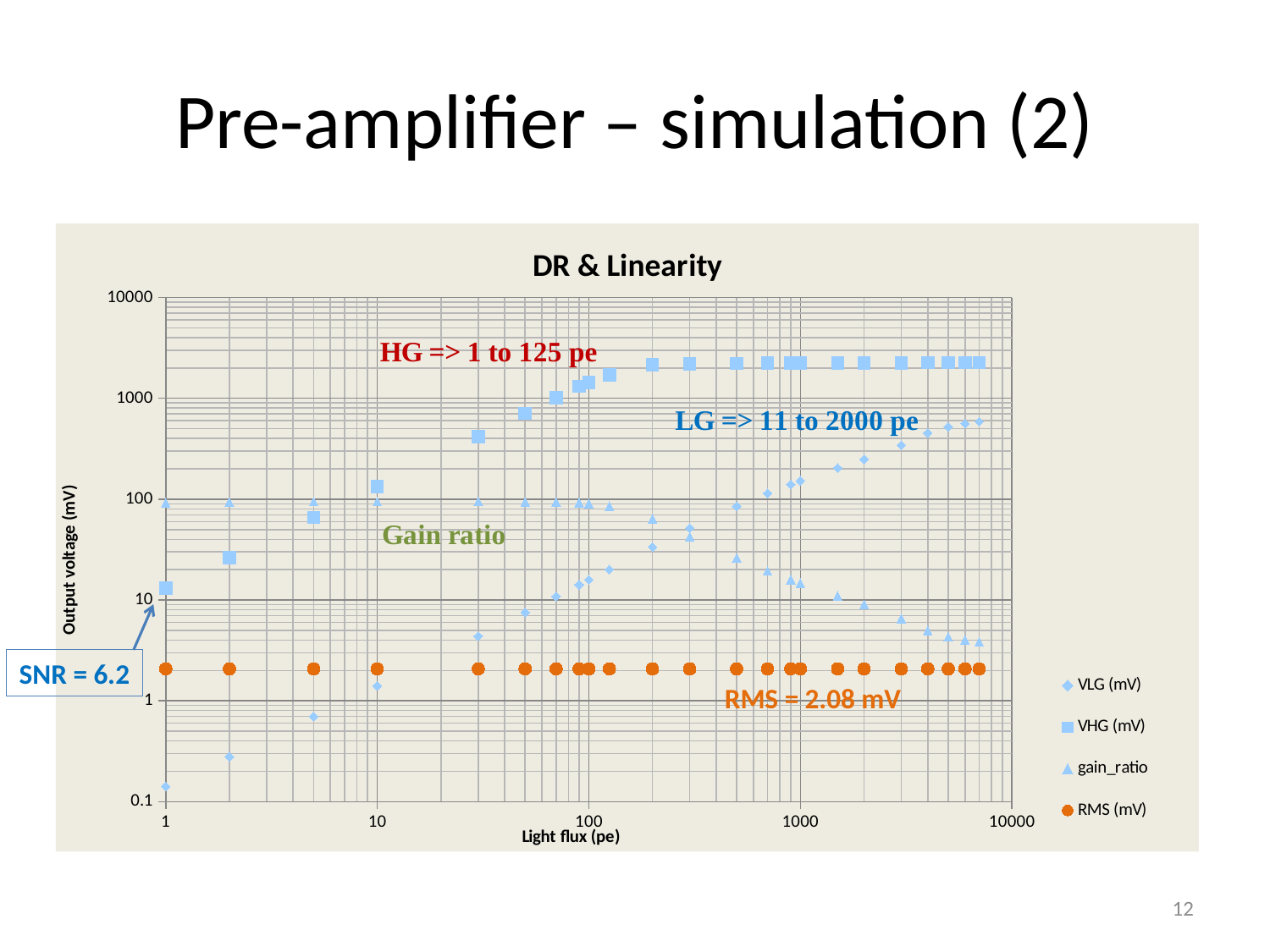
Is the gain_ratio value at a light flux of 5000 pe greater or less than 10? less What RMS value is annotated on the chart? RMS = 2.08 mV At a light flux of 1000 pe, which is larger, VHG (mV) or VLG (mV)? VHG (mV) How many series does the chart legend list? 4 Does the VLG (mV) series rise or fall as light flux increases? rise What is the title of the chart? DR & Linearity Is the VHG (mV) value at a light flux of 1000 pe greater or less than 1000? greater Does the gain_ratio series rise or fall as light flux increases beyond 100 pe? fall What is the label of the x axis? Light flux (pe) Is the VHG (mV) value at a light flux of 1 pe greater or less than 10? greater What kind of chart is shown on the slide? scatter chart